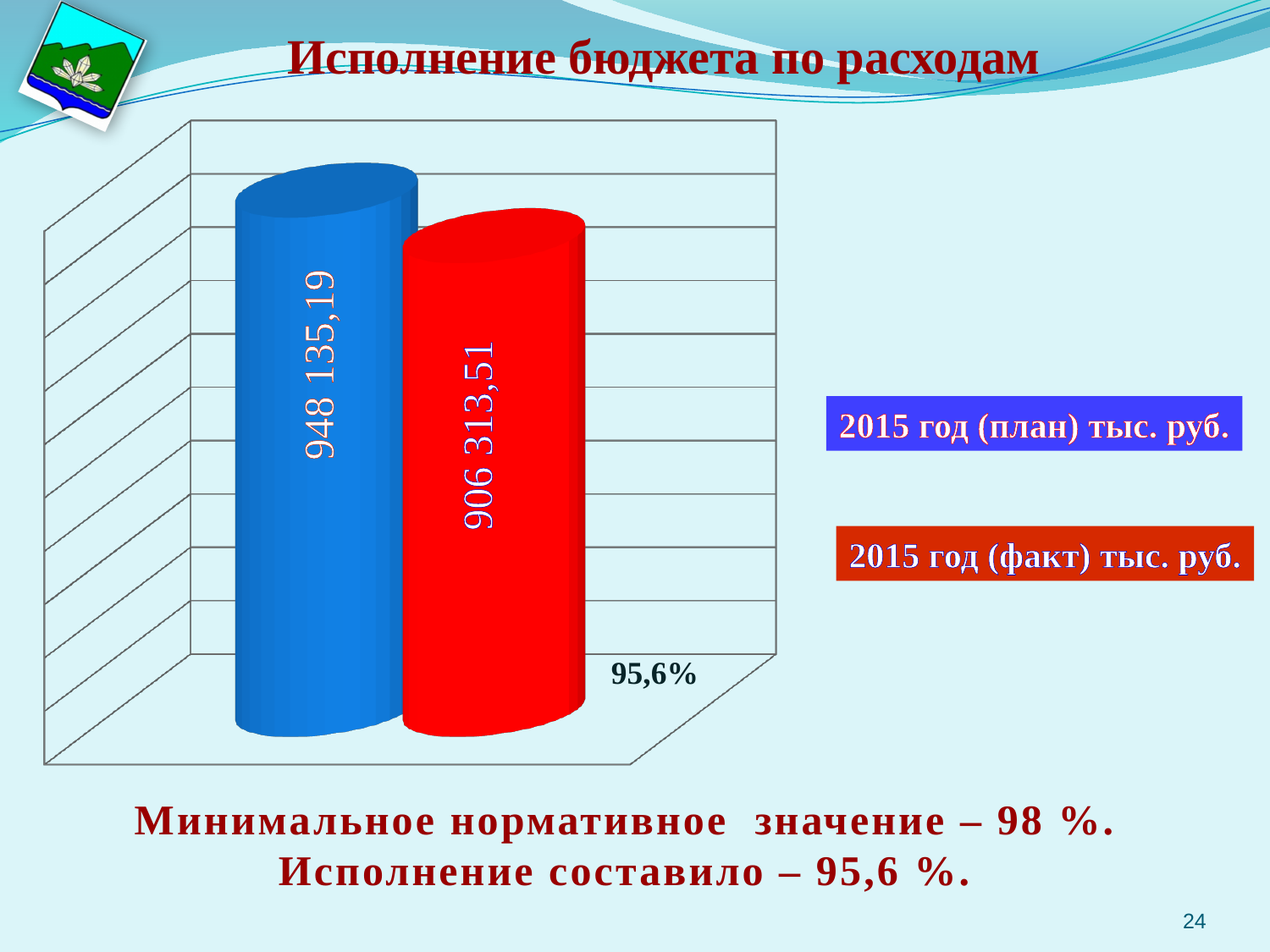
Какая серия имеет наибольшее значение на диаграмме? 2015 год (план) тыс. руб. На сколько значение плана 2015 года больше значения факта 2015 года? 41 821,68 Как называется диаграмма на слайде? Исполнение бюджета по расходам Какое значение показано для серии «2015 год (факт) тыс. руб.»? 906 313,51 Какое значение показано для серии «2015 год (план) тыс. руб.»? 948 135,19 Какой процент исполнения указан на диаграмме? 95,6% Какая серия имеет наименьшее значение на диаграмме? 2015 год (факт) тыс. руб. Какого типа эта диаграмма? Столбчатая (bar chart) Каким цветом показана серия «2015 год (факт) тыс. руб.»? Красным Что больше: план 2015 года или факт 2015 года? 2015 год (план) тыс. руб. Сколько серий перечислено в легенде диаграммы? 2 Сколько столбцов изображено на диаграмме? 2